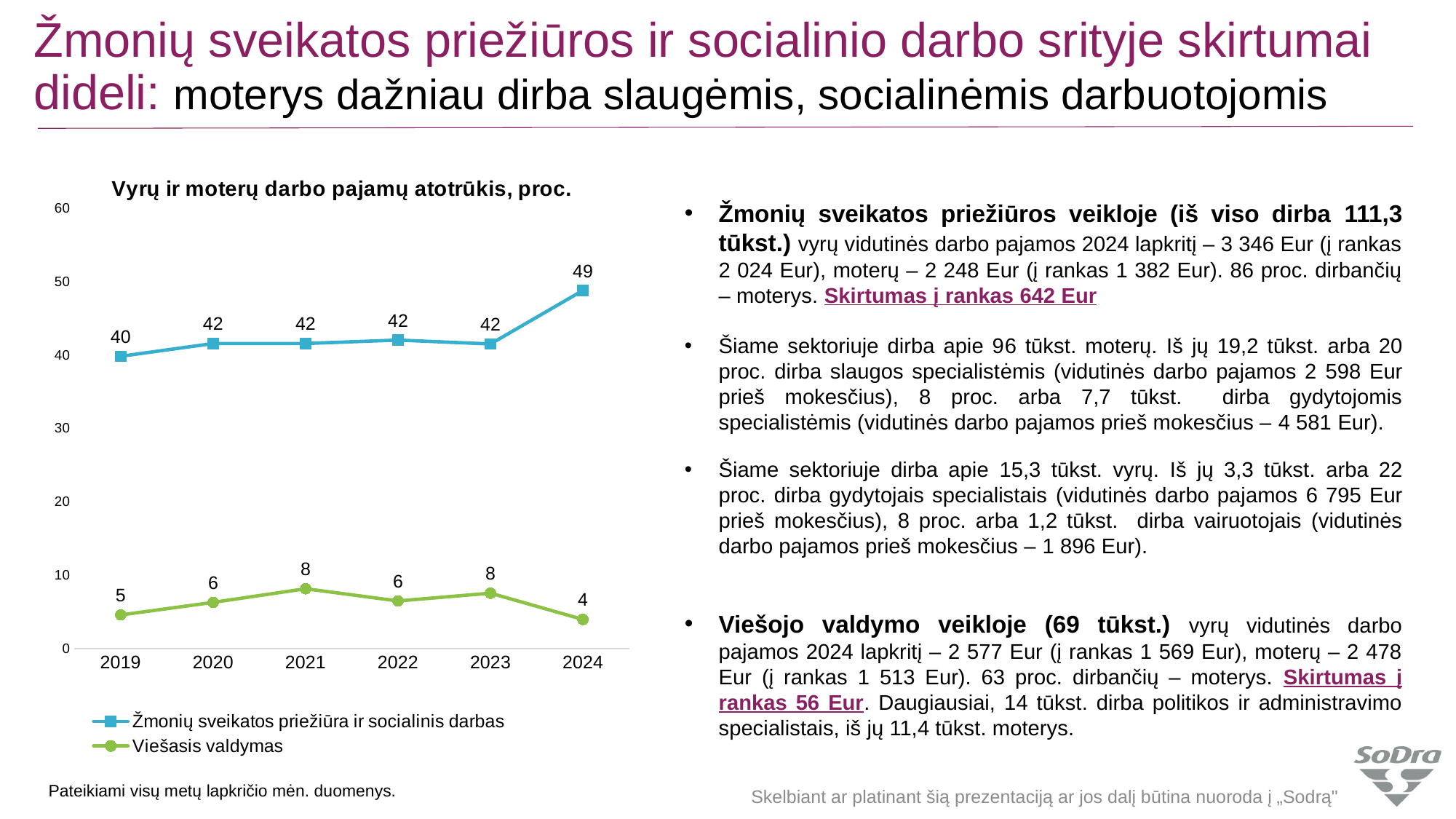
In which year is the value for Žmonių sveikatos priežiūra ir socialinis darbas highest? 2024 What is the difference between the two series in 2024? 45 What is the title of the chart? Vyrų ir moterų darbo pajamų atotrūkis, proc. Which series has the larger value in 2022? Žmonių sveikatos priežiūra ir socialinis darbas How many series does the legend list? 2 What kind of chart is shown on the slide? line chart What is the value for Žmonių sveikatos priežiūra ir socialinis darbas in 2019? 40 What is the difference between the Žmonių sveikatos priežiūra ir socialinis darbas values in 2024 and 2023? 7 How many years are shown on the x axis? 6 What is the value for Žmonių sveikatos priežiūra ir socialinis darbas in 2024? 49 What is the value for Viešasis valdymas in 2021? 8 In which year is the value for Viešasis valdymas lowest? 2024